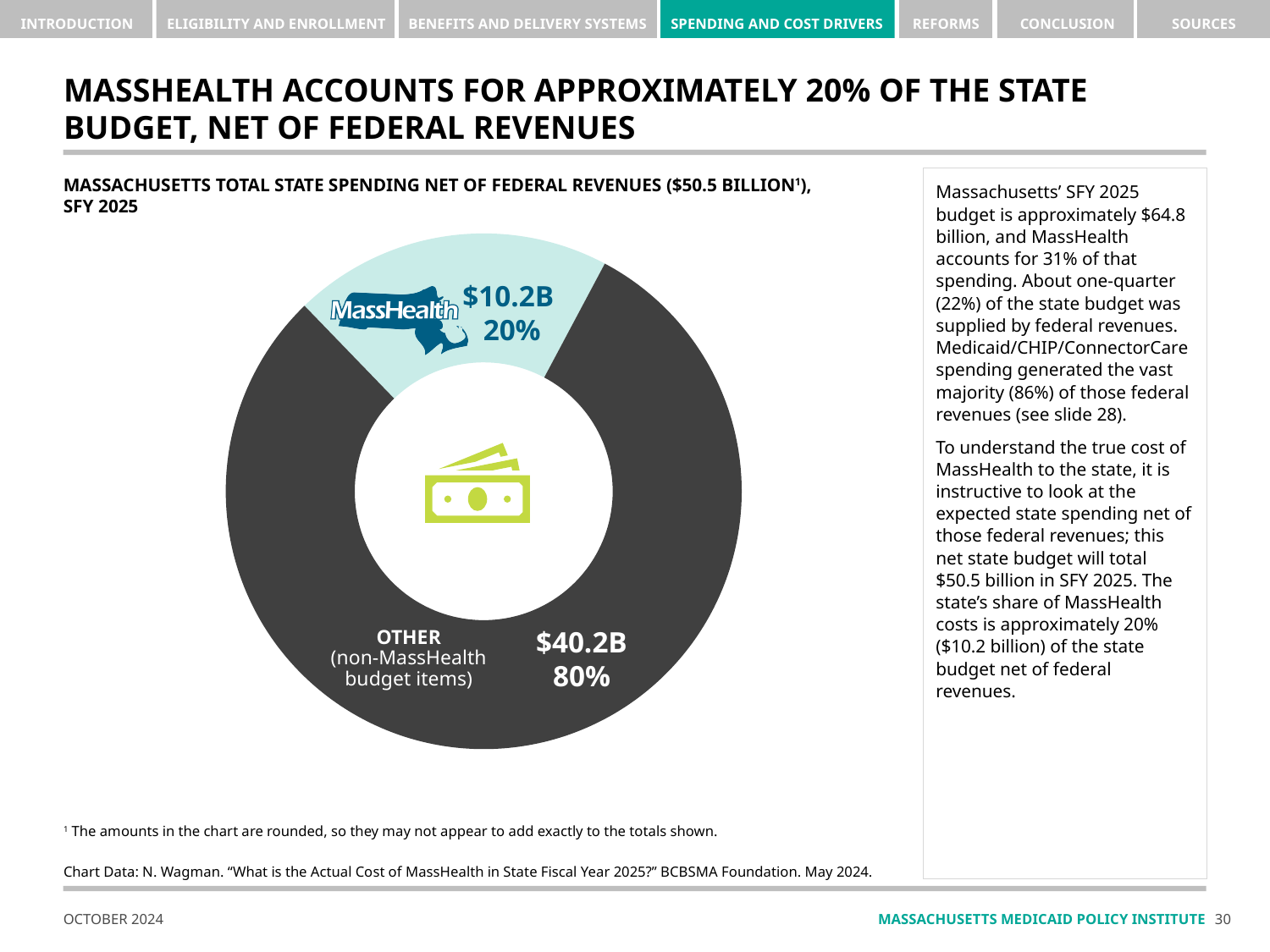
Which slice is the smallest in the chart? MassHealth How many slices does the chart have? 2 What share of the chart does the Other (non-MassHealth budget items) slice represent? 80% Which slice is the largest in the chart? Other (non-MassHealth budget items) What share of the chart does the MassHealth slice represent? 20% What fiscal year does the chart cover? SFY 2025 Which is larger, the MassHealth slice or the Other slice? Other What kind of chart is shown on the slide? Pie chart (donut) What total amount is stated in the chart title for Massachusetts total state spending net of federal revenues? $50.5 billion What is the dollar value shown for the Other (non-MassHealth budget items) slice? $40.2B What is the dollar value shown for the MassHealth slice? $10.2B What is the difference in dollars between the Other slice and the MassHealth slice? $30.0B